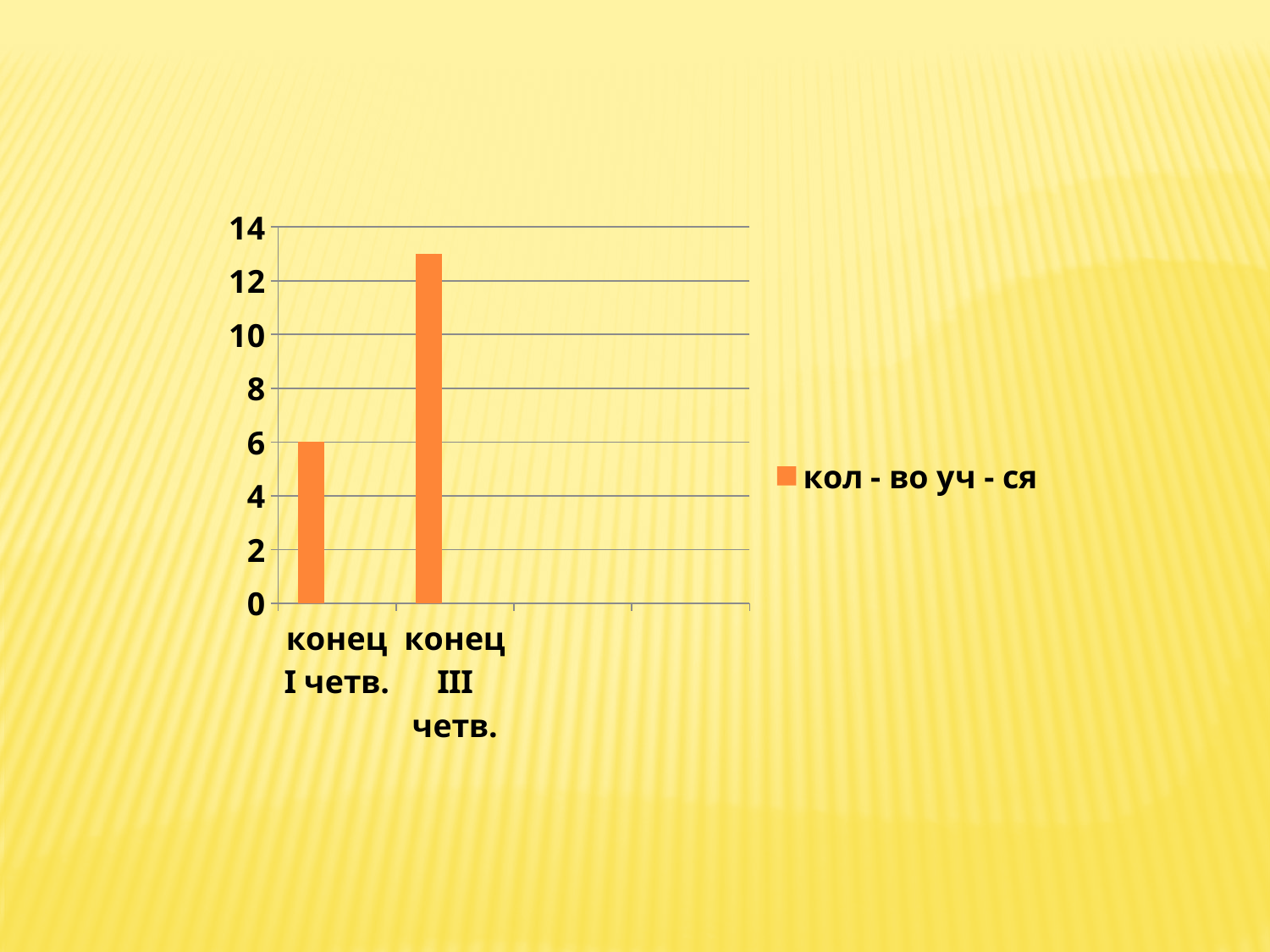
How many categories are shown on the x axis? 2 Is the value for конец III четв. greater or less than 14? less What kind of chart is shown on the slide? bar chart Is the value for конец I четв. greater or less than 8? less Which category has the highest value? конец III четв. What is the value for конец I четв.? 6 Do the values rise or fall from конец I четв. to конец III четв.? rise Is the value for конец III четв. greater or less than 12? greater Which is larger, the value for конец I четв. or the value for конец III четв.? конец III четв. What is the name of the series shown in the legend? кол - во уч - ся Which category has the lowest value? конец I четв. How many series does the legend list? 1